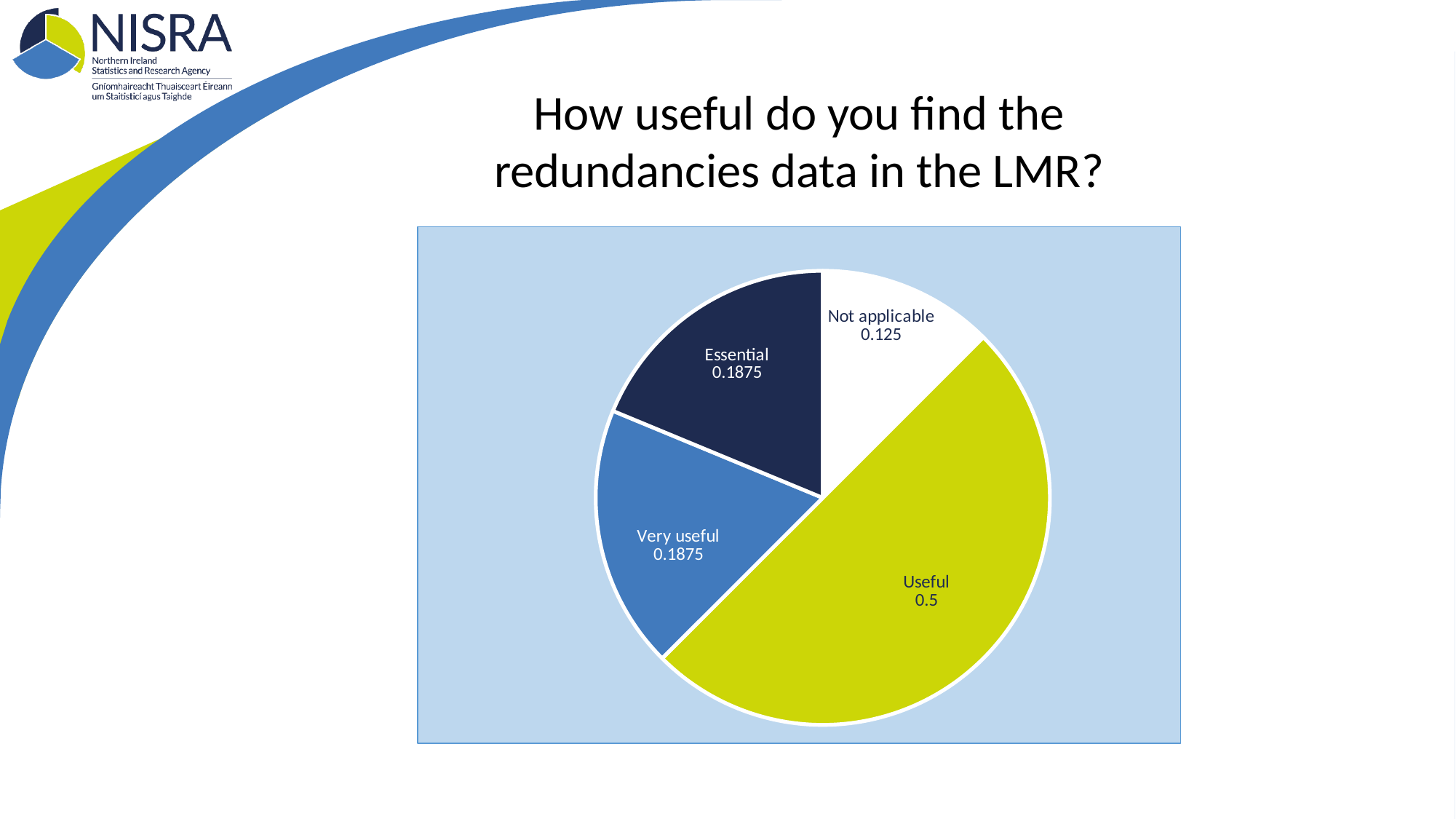
What is the value for the Very useful slice? 0.1875 What kind of chart is shown on the slide? pie chart Which is larger, the value for Essential or the value for Not applicable? Essential How many slices does the pie chart have? 4 What is the value for the Not applicable slice? 0.125 Which category has the largest slice of the pie? Useful What share of the pie does the Useful slice represent? 0.5 Which category has the smallest slice of the pie? Not applicable What is the value for the Essential slice? 0.1875 What is the value for the Useful slice? 0.5 What is the title of the slide above the chart? How useful do you find the redundancies data in the LMR? What is the difference between the values for Useful and Not applicable? 0.375